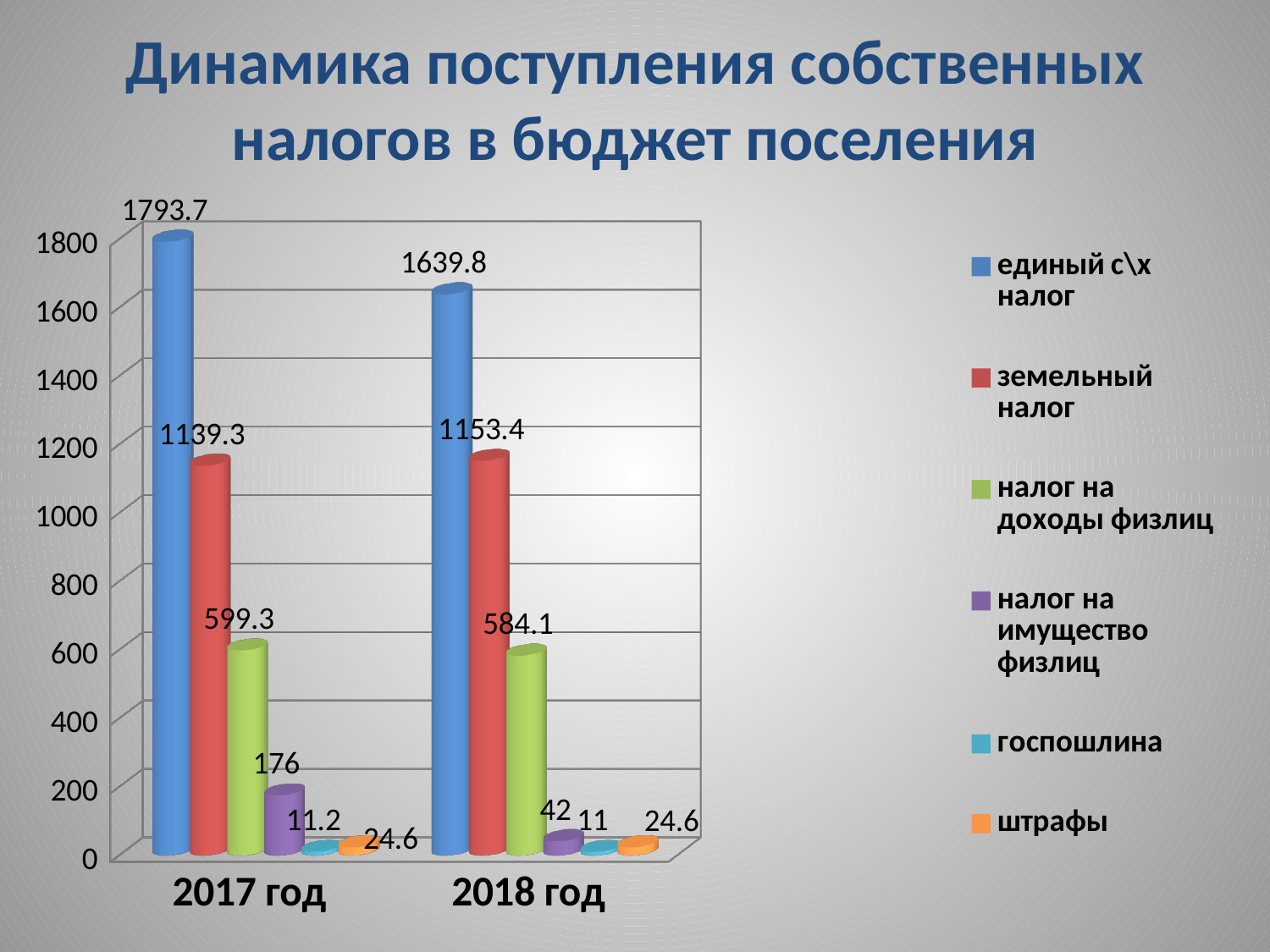
Which series has the highest value in 2018 год? единый с\х налог What is the value of единый с\х налог for 2017 год? 1793.7 What is the value of госпошлина for 2017 год? 11.2 What is the value of налог на имущество физлиц for 2018 год? 42 How many categories are shown on the x axis? 2 What is the value of земельный налог for 2018 год? 1153.4 Does the value of налог на доходы физлиц rise or fall from 2017 год to 2018 год? fall How many series does the legend list? 6 What kind of chart is shown on the slide? bar chart What is the difference between единый с\х налог in 2017 год and in 2018 год? 153.9 Which series has the lowest value in 2017 год? госпошлина Which is larger: земельный налог in 2017 год or in 2018 год? 2018 год